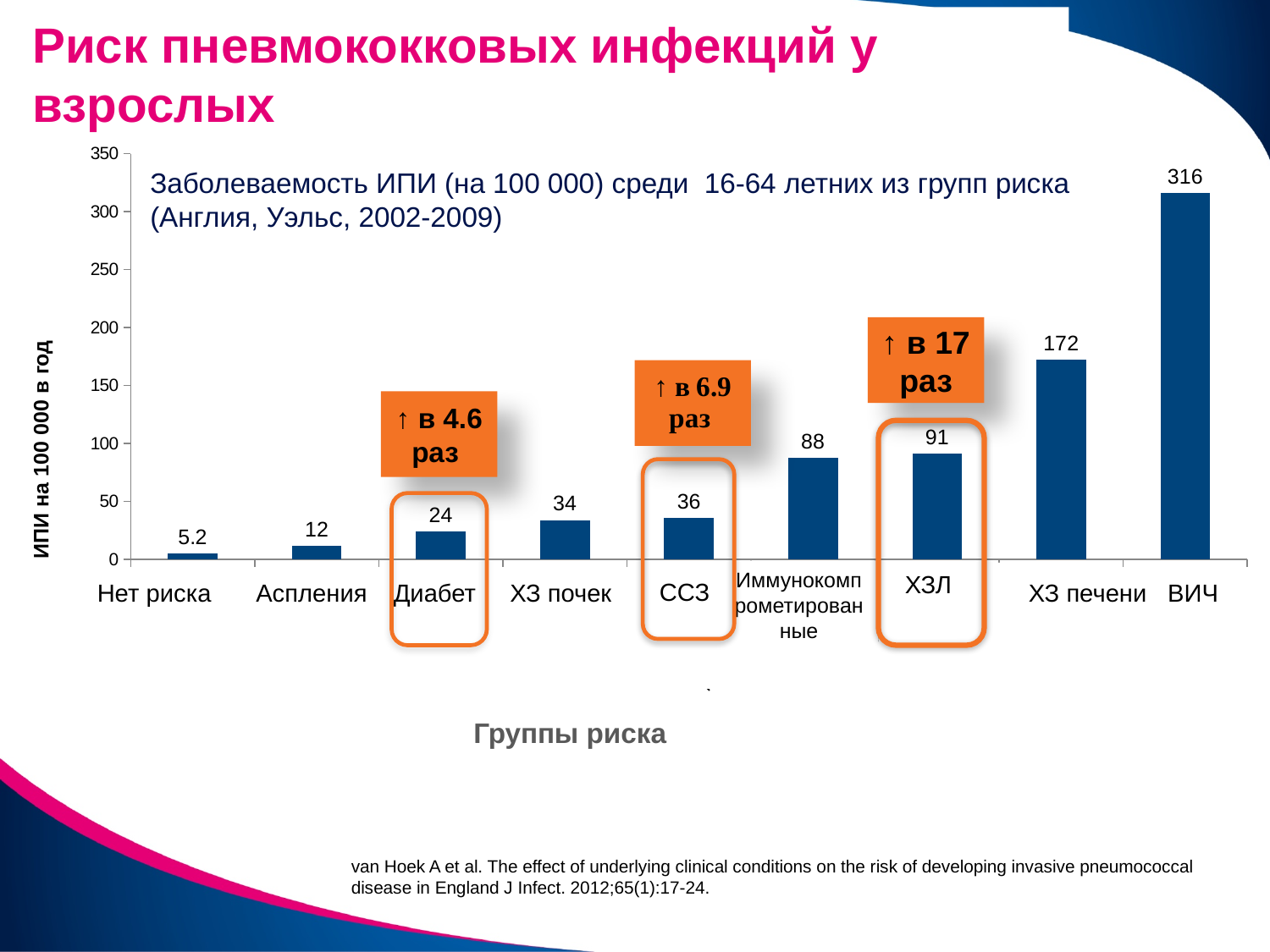
What kind of chart is this? bar chart Which category has the lowest value? Нет риска Which category has the highest value? ВИЧ Do the values rise or fall from left to right along the x axis? rise Is the value for ХЗ печени greater or less than 150? greater What is the value for ВИЧ? 316 How many categories are shown on the x axis? 9 What is the difference between the values for ВИЧ and ХЗ печени? 144 Which is larger, the value for ХЗЛ or the value for Иммунокомпрометированные? ХЗЛ What is the value for Нет риска? 5.2 What is the value for Диабет? 24 What is the label of the y axis? ИПИ на 100 000 в год